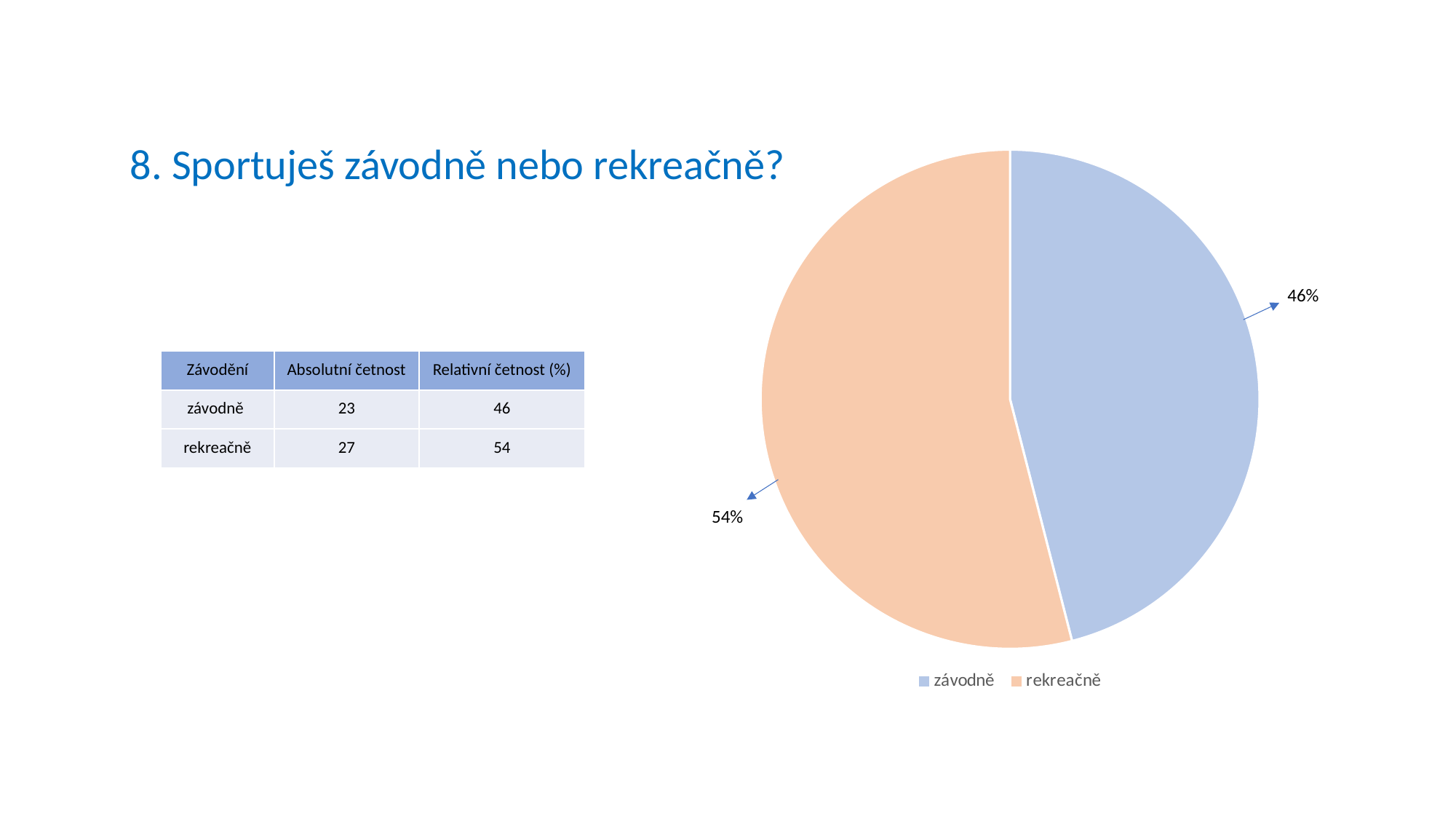
How many entries does the legend list? 2 Where is the legend positioned relative to the pie chart? below the chart Which is larger, the share for "závodně" or the share for "rekreačně"? rekreačně Which slice of the pie is the largest? rekreačně What share of the pie does the "rekreačně" slice represent? 54% What is the difference in percentage points between the "rekreačně" and "závodně" slices? 8 What share of the pie does the "závodně" slice represent? 46% What kind of chart is shown on the slide? pie chart Which slice of the pie is the smallest? závodně How many slices does the pie chart have? 2 Is the share for "rekreačně" greater or less than 50%? greater What colour is the "závodně" slice in the pie chart? blue